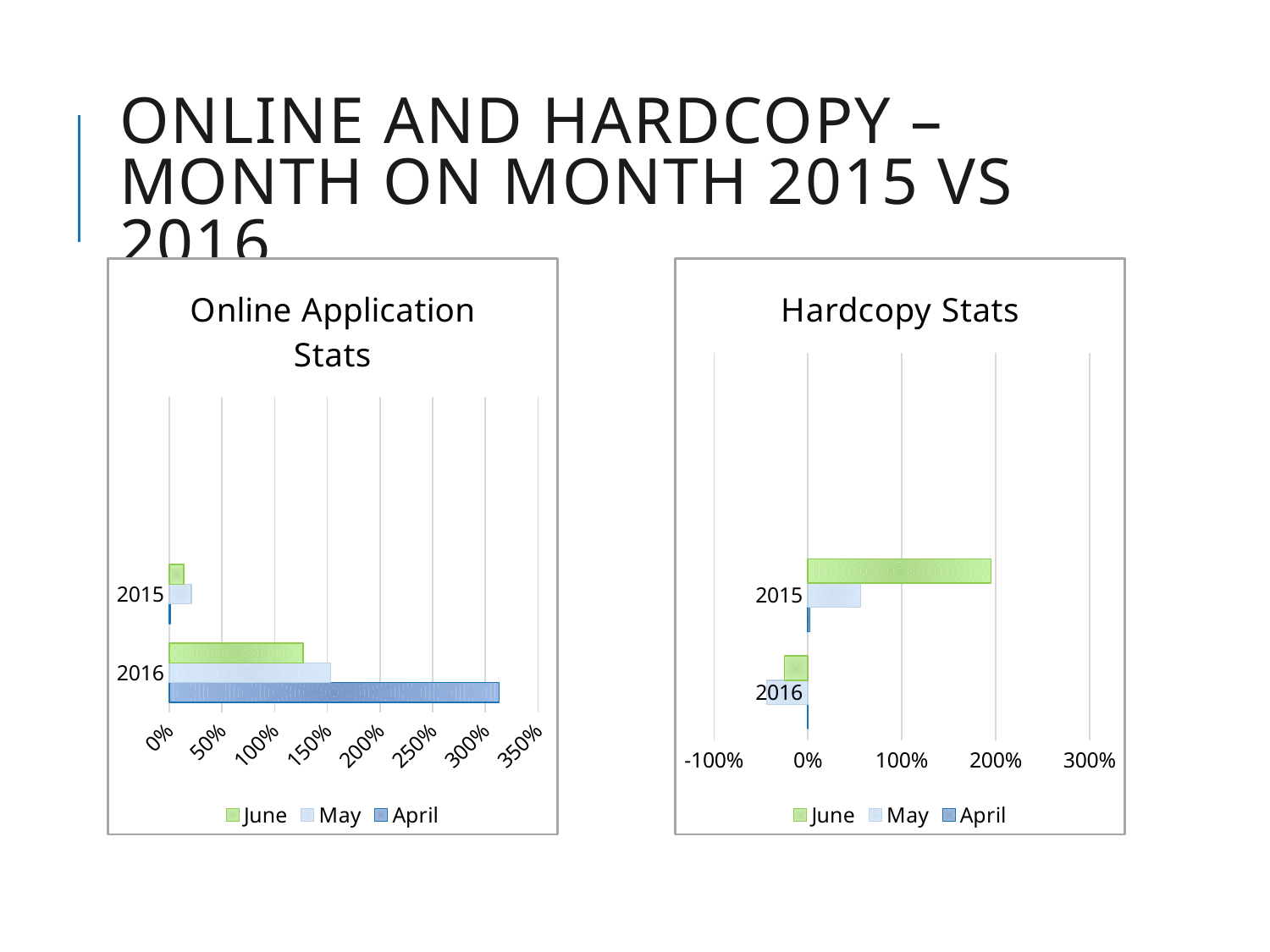
In the Online Application Stats chart, is the May value for 2016 greater or less than 200%? less In the Hardcopy Stats chart, is the June value for 2015 greater or less than 100%? greater How many year categories are shown on the Hardcopy Stats chart? 2 In the Hardcopy Stats chart, which is larger for 2015, the June value or the May value? June In the Online Application Stats chart, which month has the highest value for 2016? April In the Hardcopy Stats chart, which month has the highest value for 2015? June In the Online Application Stats chart, is the April value for 2016 greater or less than 300%? greater How many series does the legend of the Online Application Stats chart list? 3 In the Online Application Stats chart, which is larger for 2016, the April value or the June value? April What are the legend entries of the Hardcopy Stats chart? June, May, April What kind of chart is the Online Application Stats chart? bar chart